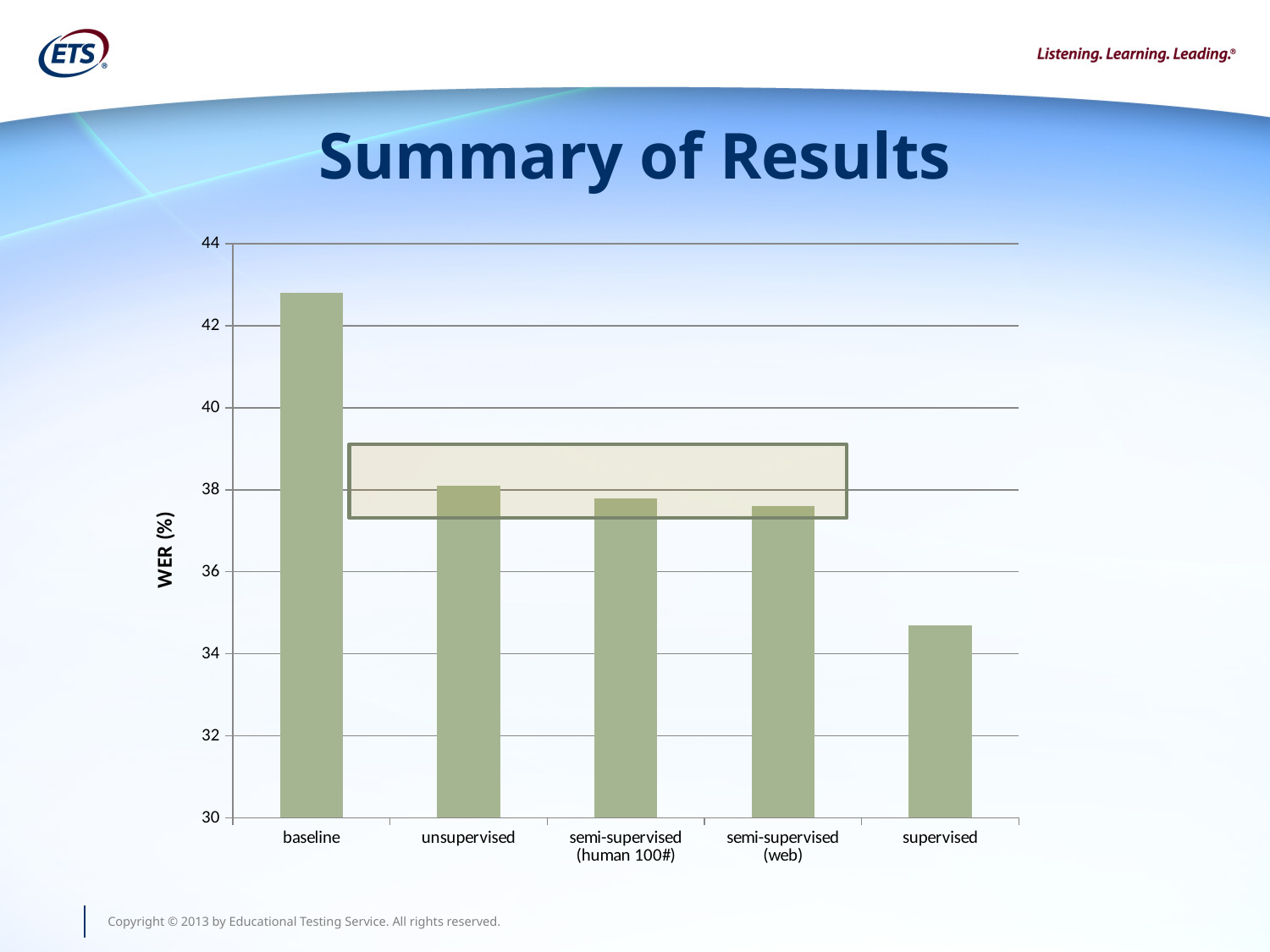
Which has a higher WER (%), unsupervised or semi-supervised (web)? unsupervised Is the WER (%) for semi-supervised (web) greater or less than 38? less How many categories are shown on the x axis of the chart? 5 Is the WER (%) for supervised greater or less than 36? less What kind of chart is shown on the slide? bar chart Is the WER (%) for baseline greater or less than 42? greater Do the WER (%) values rise or fall moving from left to right along the x axis? fall Which has a higher WER (%), baseline or supervised? baseline Which category has the lowest WER (%)? supervised Which category has the highest WER (%)? baseline What is the label on the y axis of the chart? WER (%)